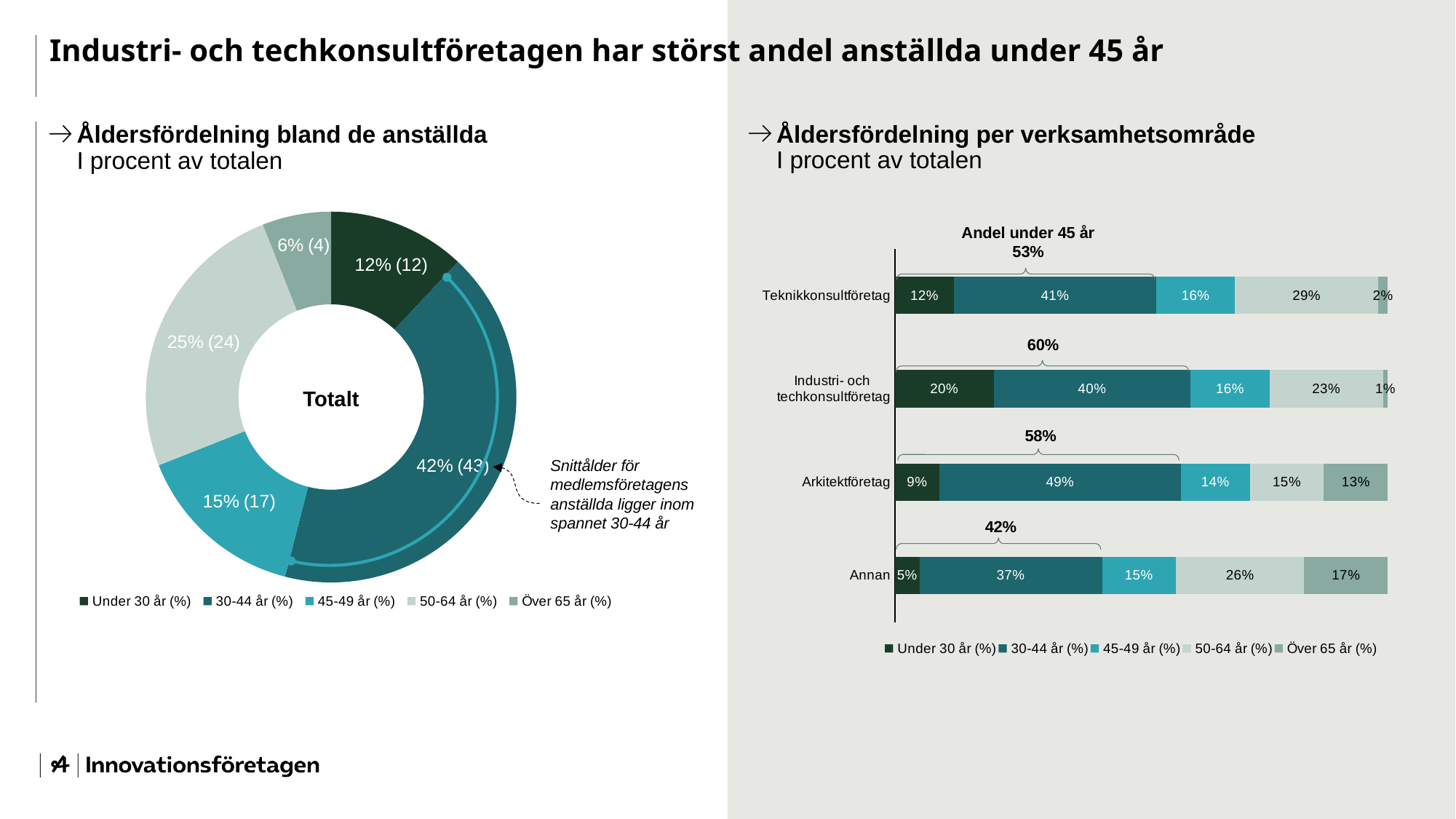
In the 'Åldersfördelning per verksamhetsområde' chart, what is the 30-44 år share for Arkitektföretag? 49% In the 'Åldersfördelning bland de anställda' chart, which age group has the smallest share? Över 65 år In the 'Åldersfördelning bland de anställda' chart, which age group has the largest share? 30-44 år What kind of chart is 'Åldersfördelning bland de anställda'? Donut (pie) chart In the 'Åldersfördelning per verksamhetsområde' chart, which category has the highest 'Andel under 45 år'? Industri- och techkonsultföretag In the 'Åldersfördelning bland de anställda' chart, how many age groups does the legend list? 5 In the 'Åldersfördelning per verksamhetsområde' chart, what is the difference between the Över 65 år share for Annan and for Teknikkonsultföretag? 15% In the 'Åldersfördelning per verksamhetsområde' chart, what is the Under 30 år share for Industri- och techkonsultföretag? 20% What kind of chart is 'Åldersfördelning per verksamhetsområde'? Stacked bar chart How many categories (verksamhetsområden) are shown in the 'Åldersfördelning per verksamhetsområde' chart? 4 In the 'Åldersfördelning per verksamhetsområde' chart, which has a larger 50-64 år share: Teknikkonsultföretag or Arkitektföretag? Teknikkonsultföretag In the 'Åldersfördelning bland de anställda' chart, what share of employees is in the 30-44 år group? 42%